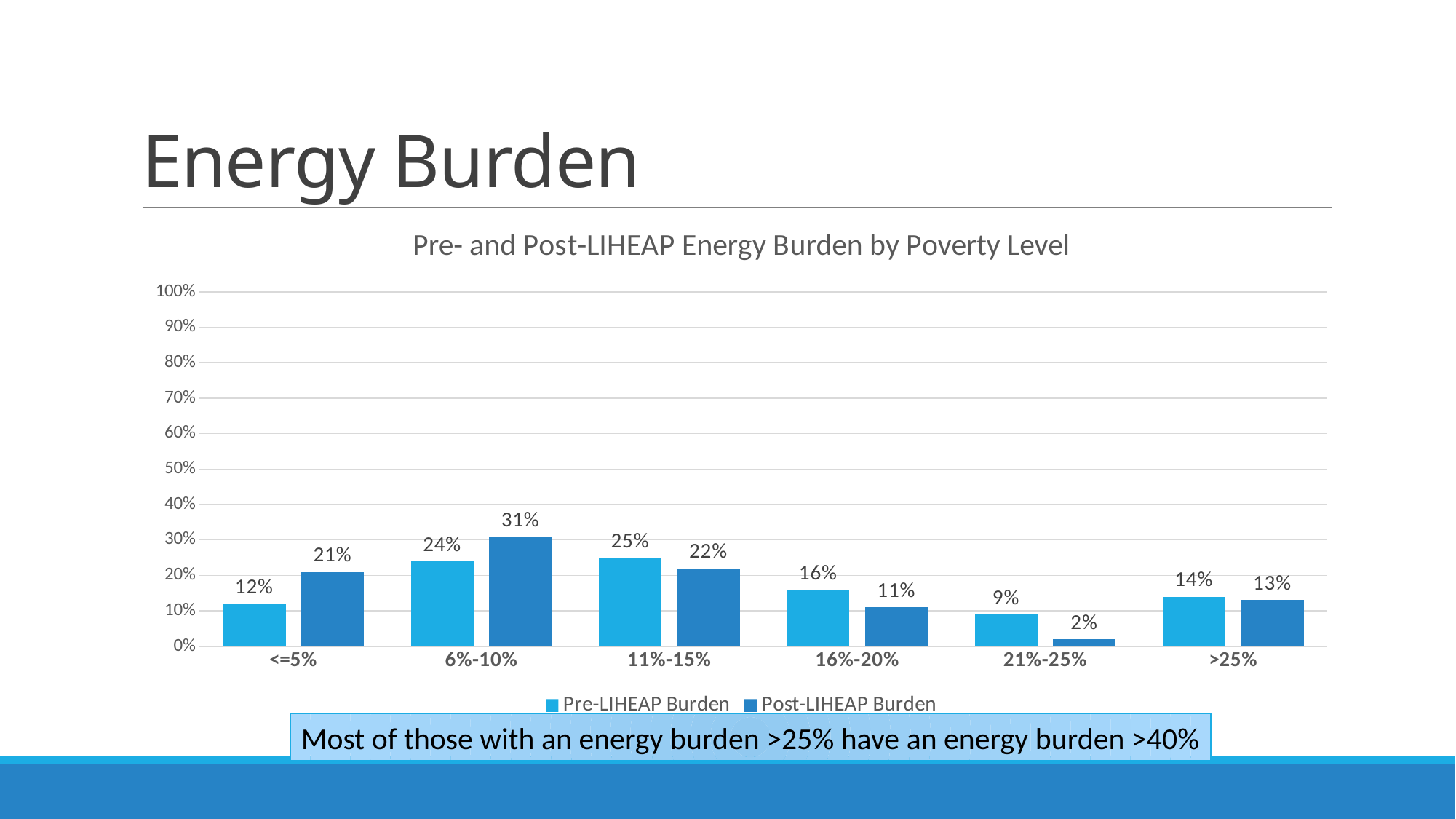
Which category has the lowest Pre-LIHEAP Burden value? 21%-25% What kind of chart is shown on the slide? Bar chart Is the Post-LIHEAP Burden value for the 6%-10% category greater or less than 30%? greater Which is larger for the 11%-15% category: the Pre-LIHEAP Burden or the Post-LIHEAP Burden? Pre-LIHEAP Burden What is the difference between the Pre-LIHEAP and Post-LIHEAP Burden values for the 16%-20% category? 5% What is the Pre-LIHEAP Burden value for the 6%-10% category? 24% How many series does the legend list? 2 How many poverty level categories are shown on the x axis? 6 What is the Post-LIHEAP Burden value for the 21%-25% category? 2% Which category has the highest Post-LIHEAP Burden value? 6%-10% What is the Post-LIHEAP Burden value for the <=5% category? 21% What is the title of the chart? Pre- and Post-LIHEAP Energy Burden by Poverty Level